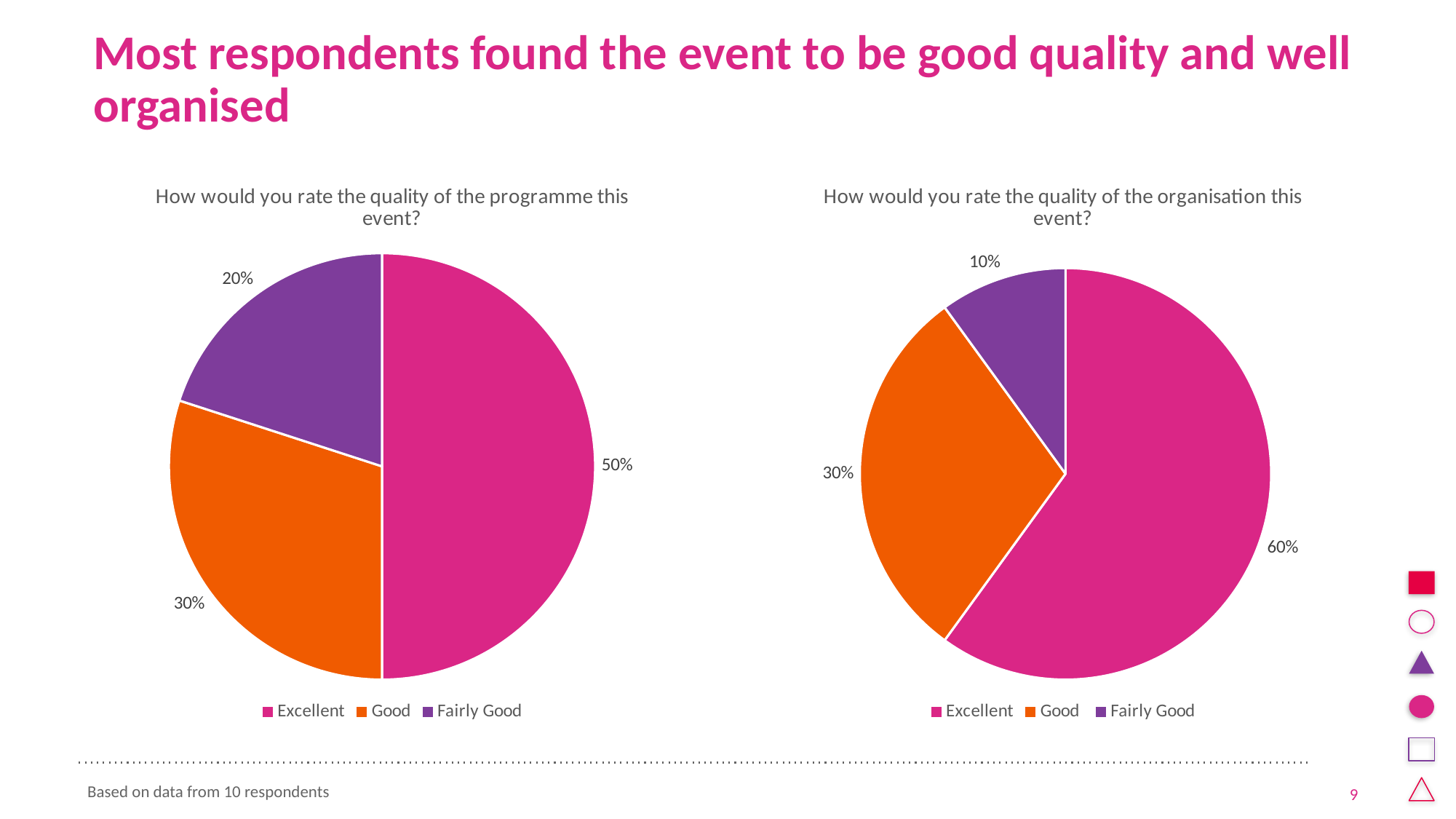
How many categories does the legend of the right chart 'How would you rate the quality of the organisation this event?' list? 3 In the left chart 'How would you rate the quality of the programme this event?', what share of respondents rated it Excellent? 50% In the right chart 'How would you rate the quality of the organisation this event?', what share of respondents rated it Excellent? 60% In the left chart 'How would you rate the quality of the programme this event?', what share of respondents rated it Good? 30% In the left chart 'How would you rate the quality of the programme this event?', what colour is the Good slice? Orange In the left chart 'How would you rate the quality of the programme this event?', which is larger: the Good slice or the Fairly Good slice? Good In the right chart 'How would you rate the quality of the organisation this event?', which rating has the largest slice? Excellent In the left chart 'How would you rate the quality of the programme this event?', which rating has the smallest slice? Fairly Good What type of chart is used on the left for 'How would you rate the quality of the programme this event?' Pie chart In the left chart 'How would you rate the quality of the programme this event?', what share of respondents rated it Fairly Good? 20% In the right chart 'How would you rate the quality of the organisation this event?', what share of respondents rated it Fairly Good? 10% In the right chart 'How would you rate the quality of the organisation this event?', what is the difference between the Excellent and Good shares? 30%